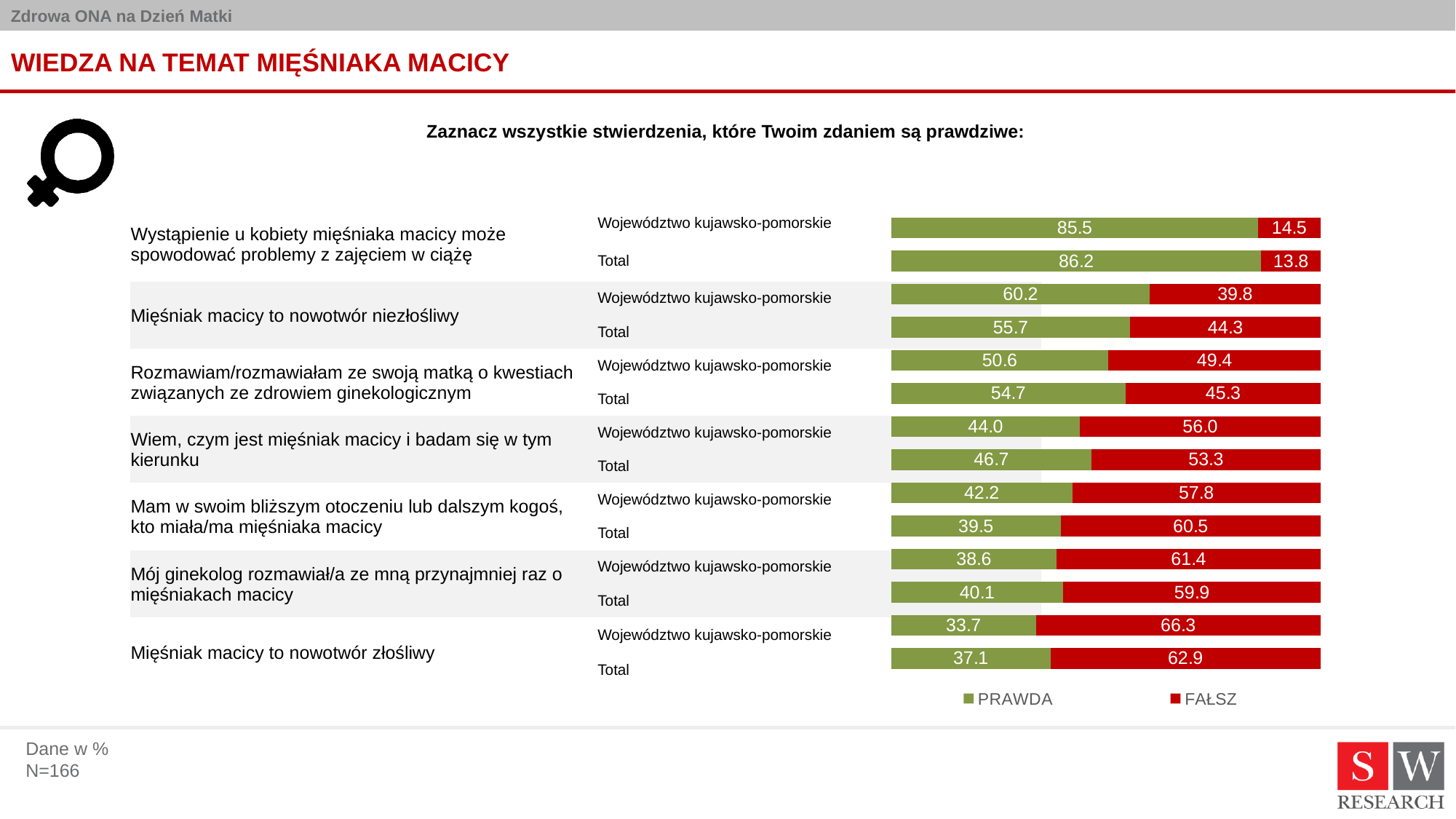
Which bar has the highest PRAWDA value? Total, 'Wystąpienie u kobiety mięśniaka macicy może spowodować problemy z zajęciem w ciążę' (86.2) What is the difference between the PRAWDA values for 'Województwo kujawsko-pomorskie' and 'Total' on the statement 'Mięśniak macicy to nowotwór niezłośliwy'? 4.5 What kind of chart is shown on the slide? Stacked bar chart Which bar has the lowest PRAWDA value? Województwo kujawsko-pomorskie, 'Mięśniak macicy to nowotwór złośliwy' (33.7) What is the FAŁSZ value for 'Total' on the statement 'Mięśniak macicy to nowotwór złośliwy'? 62.9 How many series does the legend list? 2 Which colour represents the FAŁSZ series in the chart? Red What is the PRAWDA value for 'Total' on the statement 'Wiem, czym jest mięśniak macicy i badam się w tym kierunku'? 46.7 For the statement 'Mam w swoim bliższym otoczeniu lub dalszym kogoś, kto miała/ma mięśniaka macicy', which has the larger PRAWDA value: 'Województwo kujawsko-pomorskie' or 'Total'? Województwo kujawsko-pomorskie What is the total of the stacked bar for 'Total' on the statement 'Rozmawiam/rozmawiałam ze swoją matką o kwestiach związanych ze zdrowiem ginekologicznym'? 100 What is the PRAWDA value for 'Województwo kujawsko-pomorskie' on the statement 'Mięśniak macicy to nowotwór niezłośliwy'? 60.2 How many bars are plotted in the chart? 14